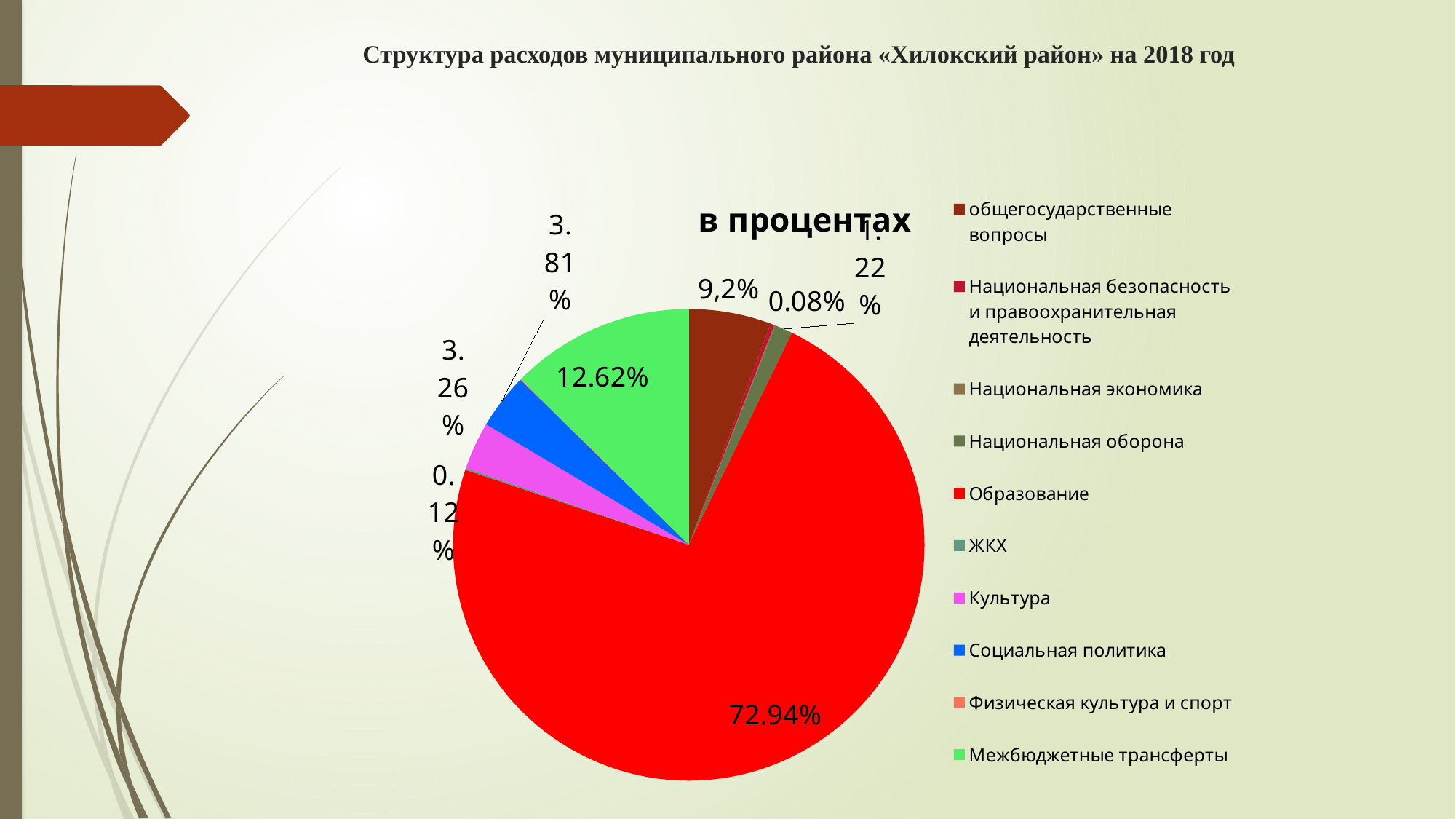
Which category has the largest slice of the pie? Образование How many categories does the chart legend list? 10 What share of expenditures is labelled for Образование? 72.94% What share is labelled for Межбюджетные трансферты? 12.62% What is the title of the chart? в процентах What colour is the slice for Образование? red What share is labelled for Социальная политика? 3.81% Which is larger: the slice for Межбюджетные трансферты or the slice for общегосударственные вопросы? Межбюджетные трансферты What share is labelled for Культура? 3.26% What share is labelled for общегосударственные вопросы? 9,2% What is the difference between the shares for Образование and Межбюджетные трансферты? 60.32% What kind of chart is shown on the slide? pie chart